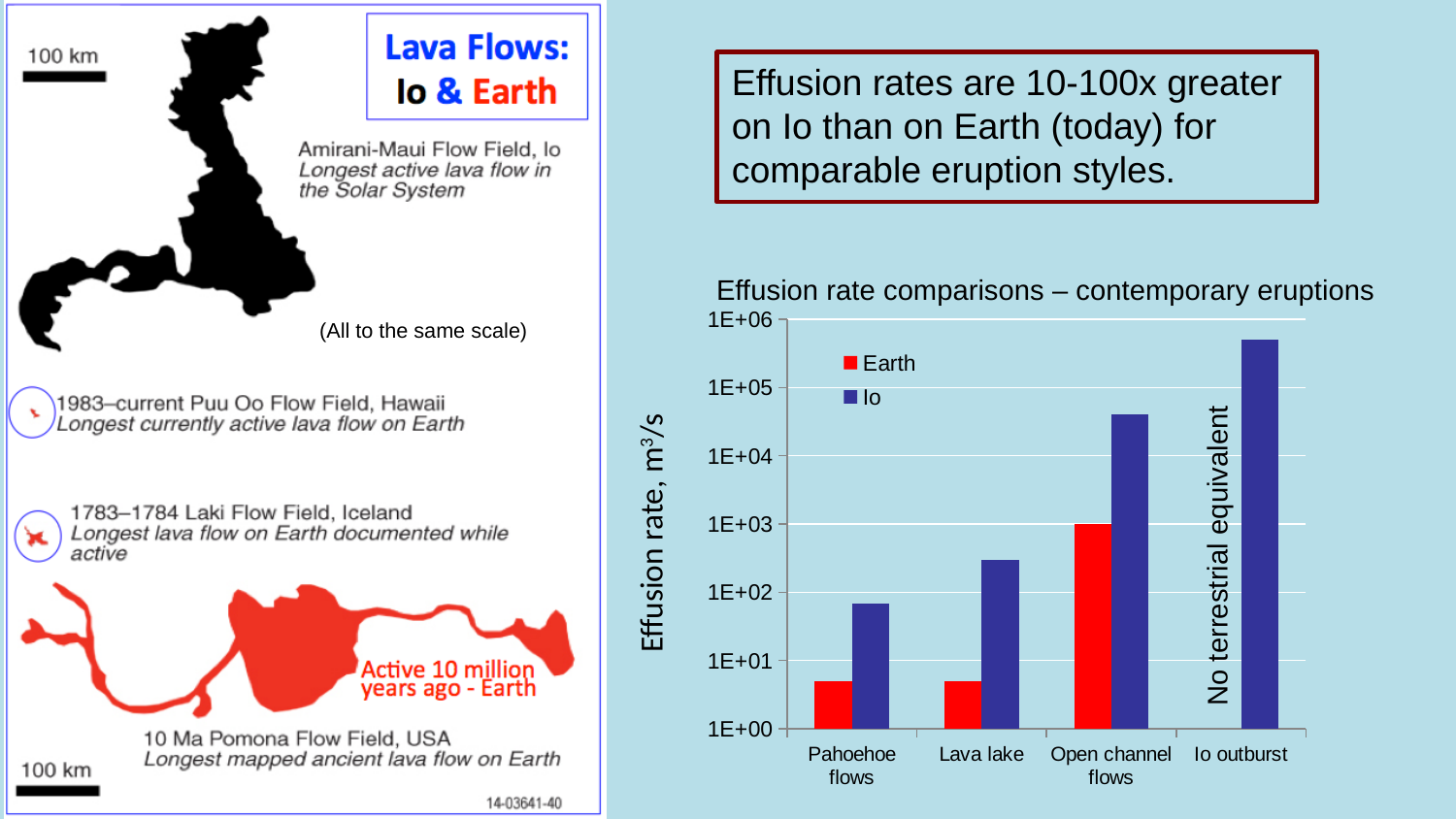
For Lava lake, which series has the larger effusion rate, Earth or Io? Io Which category has the lowest Io effusion rate? Pahoehoe flows What type of chart is shown on the slide? bar chart What is the title of the chart on the slide? Effusion rate comparisons – contemporary eruptions Is the Io effusion rate for Pahoehoe flows greater or less than 1E+02? less What is the Earth effusion rate for Open channel flows? 1E+03 Is the Io effusion rate for Open channel flows greater or less than 1E+04? greater How many categories are shown on the x axis of the chart? 4 What label is written in place of the Earth bar for Io outburst? No terrestrial equivalent Is the Io effusion rate for Io outburst greater or less than 1E+05? greater Which category has the highest Io effusion rate? Io outburst How many series does the chart legend list? 2